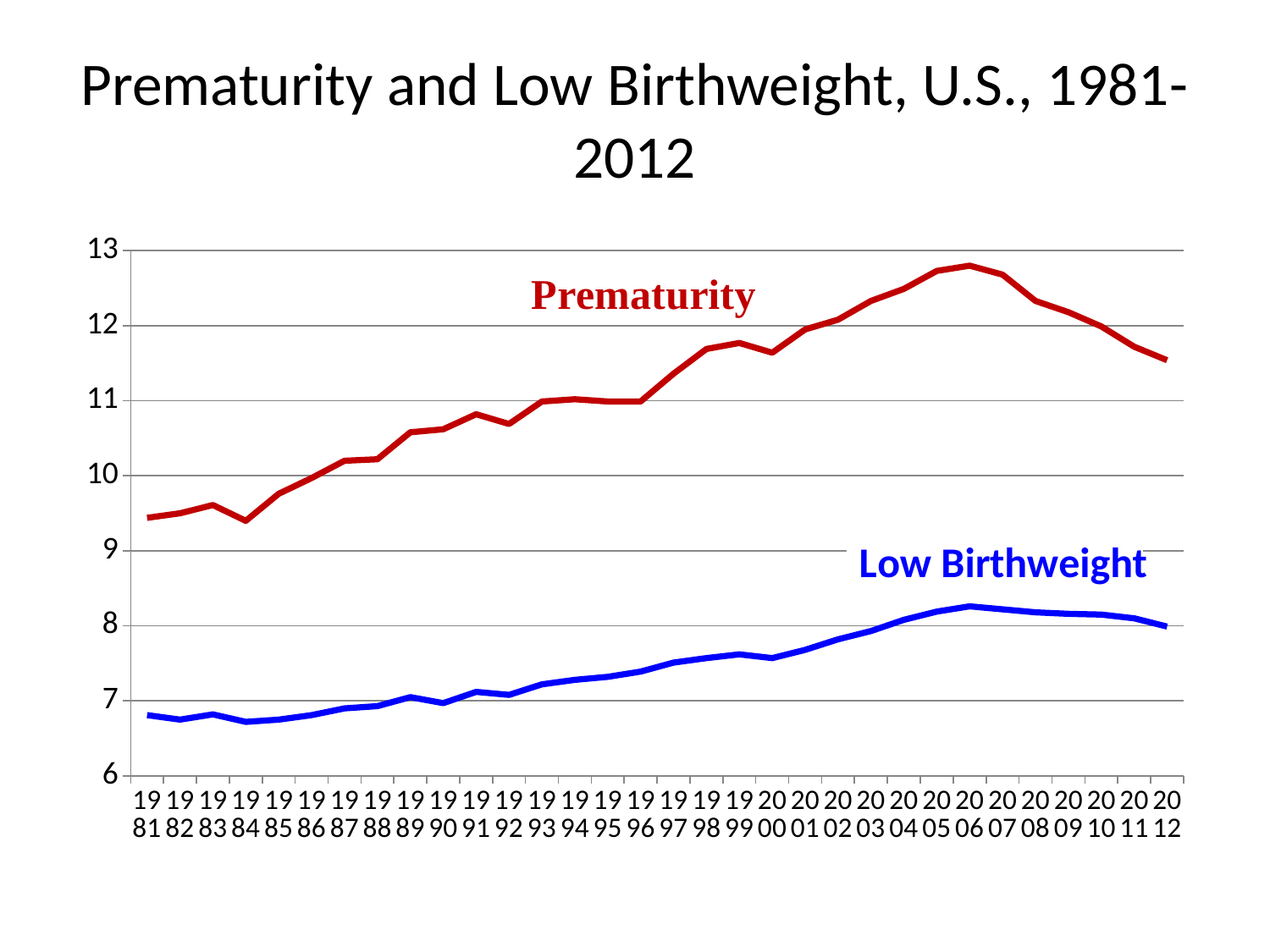
Is the Low Birthweight value for 2006 greater or less than 8? greater How many series are plotted on the chart? 2 Is the Prematurity value for 1981 greater or less than 10? less How many years are plotted along the x axis? 32 What colour is the Prematurity line? Red In which year does the Prematurity line reach its highest value? 2006 Does the Prematurity line rise or fall between 2006 and 2012? Fall Is the Prematurity value for 2006 greater or less than 12? greater What kind of chart is shown on the slide? Line chart In 2000, which series has the larger value, Prematurity or Low Birthweight? Prematurity What is the title of the chart on the slide? Prematurity and Low Birthweight, U.S., 1981-2012